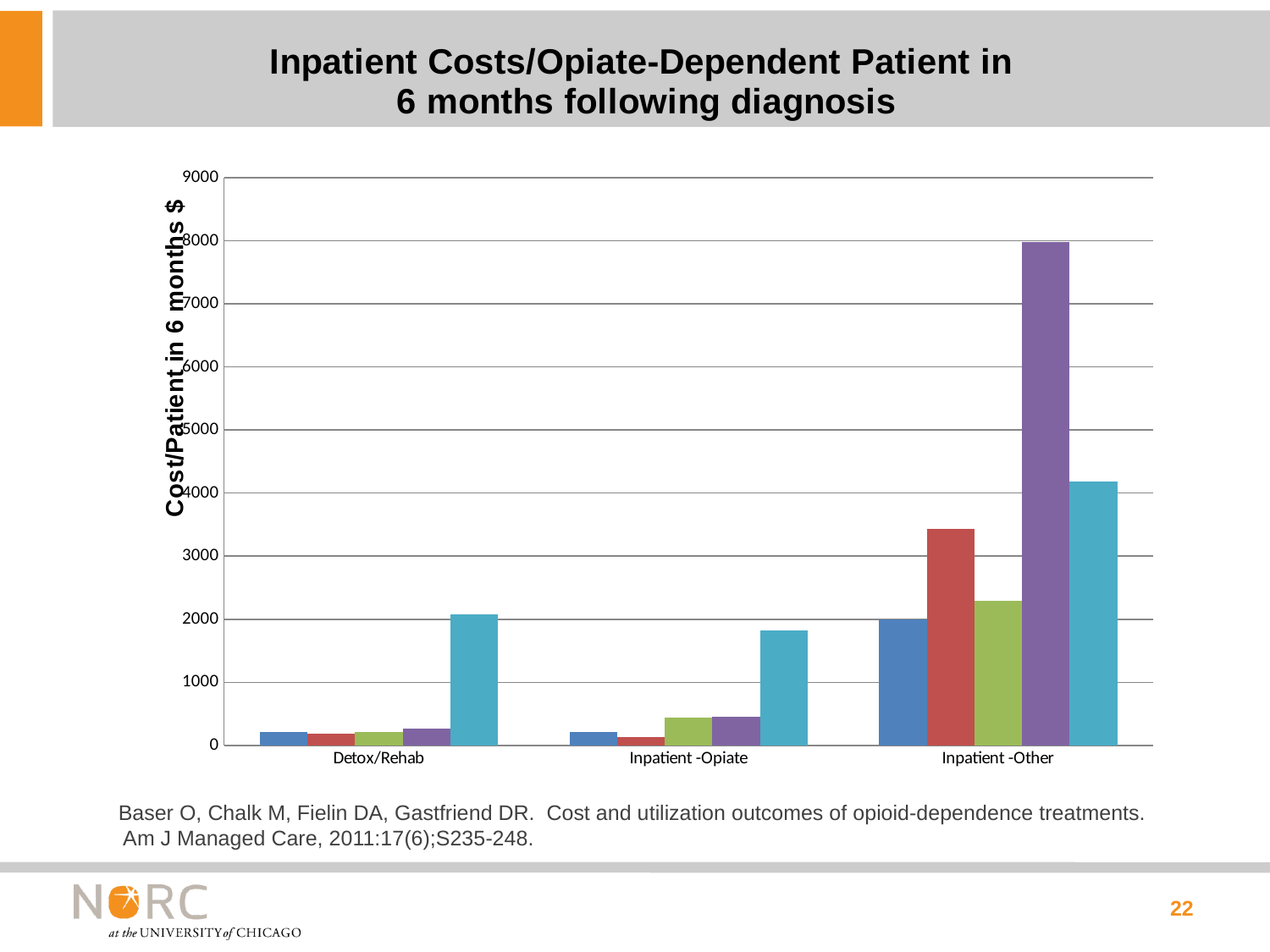
Is the value of the teal bar for Inpatient -Other greater or less than 3000? greater How many categories are shown on the x axis of the chart? 3 Which is larger: the teal bar for Detox/Rehab or the teal bar for Inpatient -Opiate? Detox/Rehab Is the value of the blue bar for Detox/Rehab greater or less than 1000? less What is the label on the vertical axis of the chart? Cost/Patient in 6 months $ Is the value of the teal bar for Detox/Rehab greater or less than 1000? greater What kind of chart is shown on the slide? bar chart Which is larger for Inpatient -Other: the purple bar or the teal bar? the purple bar Which category contains the tallest bar in the chart? Inpatient -Other